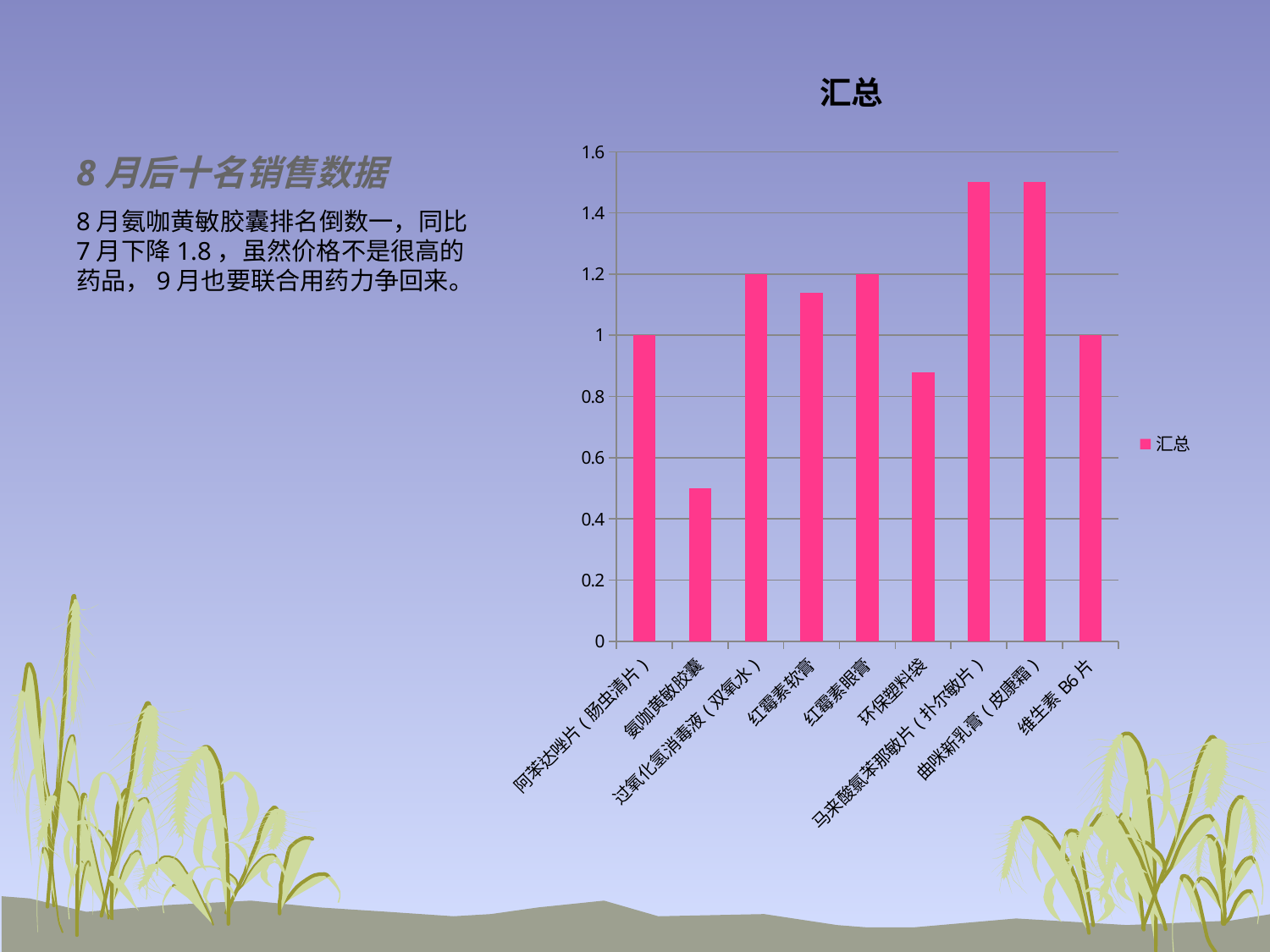
Is the value for 氨咖黄敏胶囊 greater or less than 0.6? less Which is larger, the value for 曲咪新乳膏（皮康霜）or the value for 过氧化氢消毒液（双氧水）? 曲咪新乳膏（皮康霜） How many series does the chart's legend list? 1 What is the value for 阿苯达唑片（肠虫清片）? 1 What kind of chart is shown on the slide? bar chart Is the value for 环保塑料袋 greater or less than 1? less What is the value for 维生素B6片? 1 What is the value for 过氧化氢消毒液（双氧水）? 1.2 What is the title of the chart? 汇总 Is the value for 马来酸氯苯那敏片（扑尔敏片）greater or less than 1.4? greater How many categories are plotted on the x axis of the chart? 9 Which category has the lowest value? 氨咖黄敏胶囊